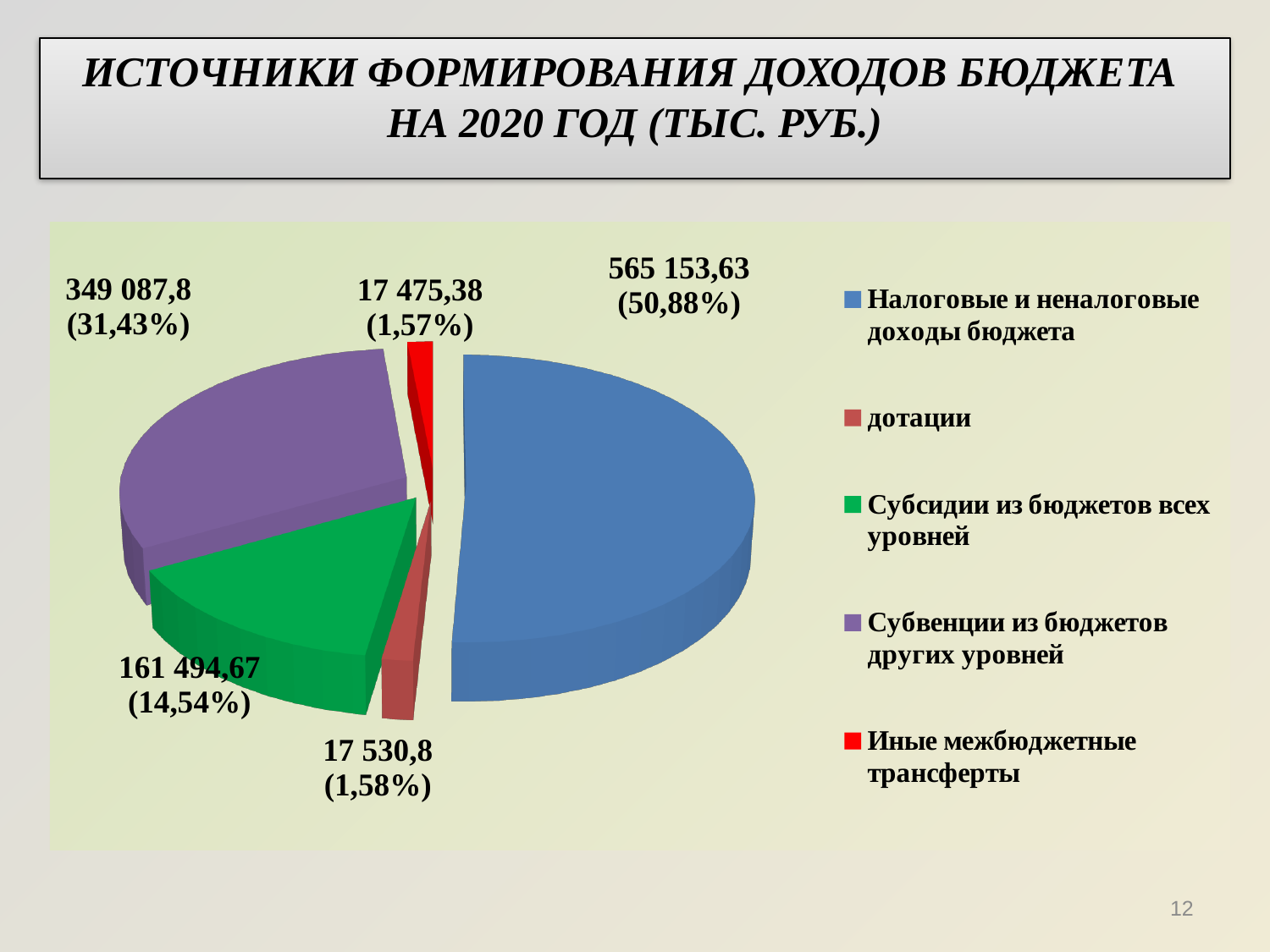
Which category has the largest slice of the pie? Налоговые и неналоговые доходы бюджета What is the value for Субвенции из бюджетов других уровней? 349 087,8 Which is larger, Субвенции из бюджетов других уровней or Субсидии из бюджетов всех уровней? Субвенции из бюджетов других уровней How many entries does the legend list? 5 What is the value for Налоговые и неналоговые доходы бюджета? 565 153,63 What share of the pie does Субсидии из бюджетов всех уровней represent? 14,54% What colour is the slice for Субсидии из бюджетов всех уровней? green What kind of chart is shown on the slide? pie chart What share of the pie does Налоговые и неналоговые доходы бюджета represent? 50,88% How many slices does the pie chart have? 5 What is the difference between the values for Налоговые и неналоговые доходы бюджета and Субвенции из бюджетов других уровней? 216 065,83 What is the value for Субсидии из бюджетов всех уровней? 161 494,67